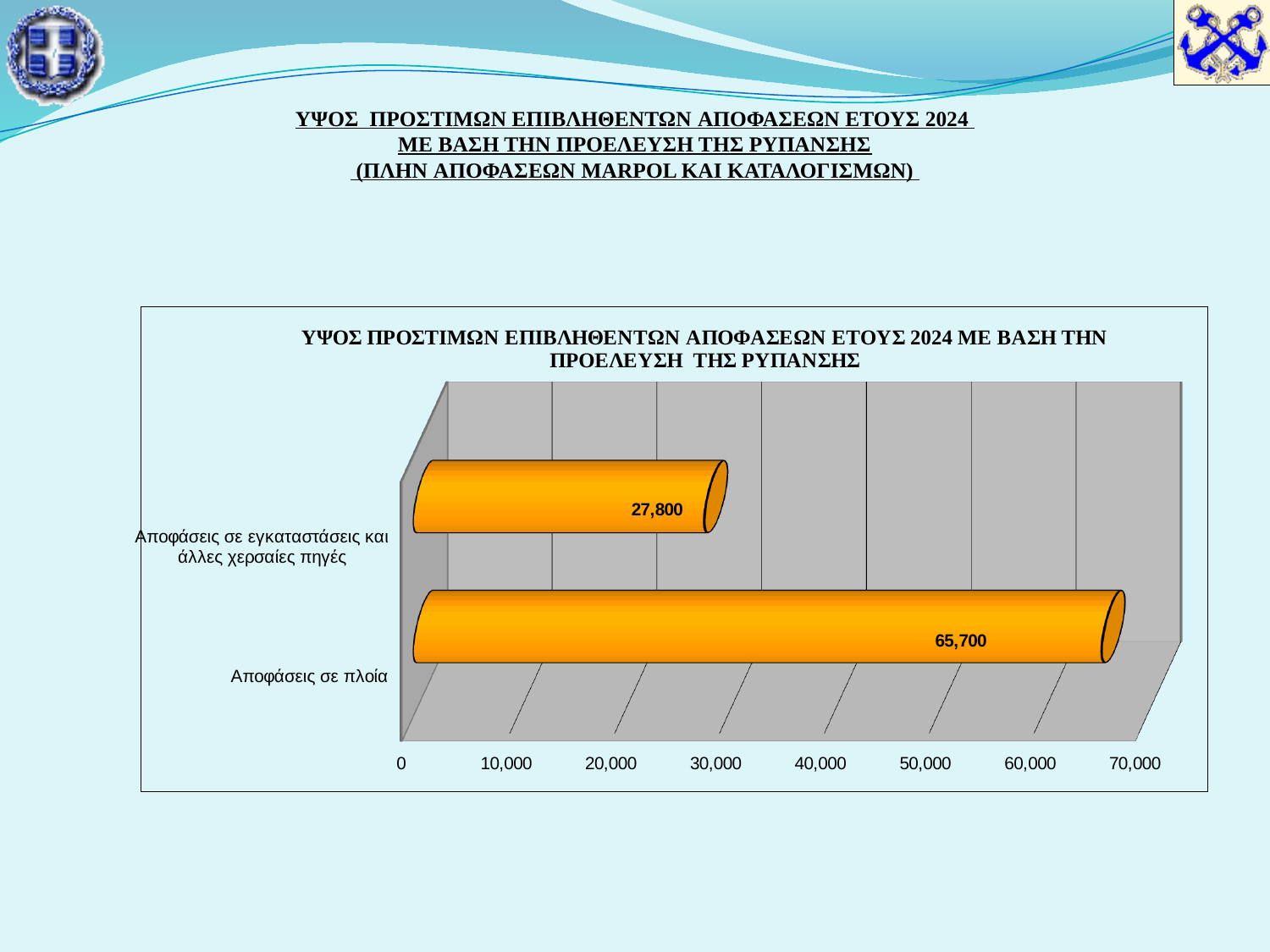
What is the value for Αποφάσεις σε εγκαταστάσεις και άλλες χερσαίες πηγές? 27,800 Is the value for Αποφάσεις σε εγκαταστάσεις και άλλες χερσαίες πηγές greater or less than 30,000? less What kind of chart is shown on the slide? bar chart What is the highest value shown on the horizontal axis of the chart? 70,000 What is the difference between the value for Αποφάσεις σε πλοία and the value for Αποφάσεις σε εγκαταστάσεις και άλλες χερσαίες πηγές? 37,900 How many categories are shown in the chart? 2 Which category has the lowest value? Αποφάσεις σε εγκαταστάσεις και άλλες χερσαίες πηγές Which is larger: the value for Αποφάσεις σε πλοία or the value for Αποφάσεις σε εγκαταστάσεις και άλλες χερσαίες πηγές? Αποφάσεις σε πλοία Which category has the highest value? Αποφάσεις σε πλοία What is the total of the two values shown in the chart? 93,500 Is the value for Αποφάσεις σε πλοία greater or less than 60,000? greater What is the value for Αποφάσεις σε πλοία? 65,700